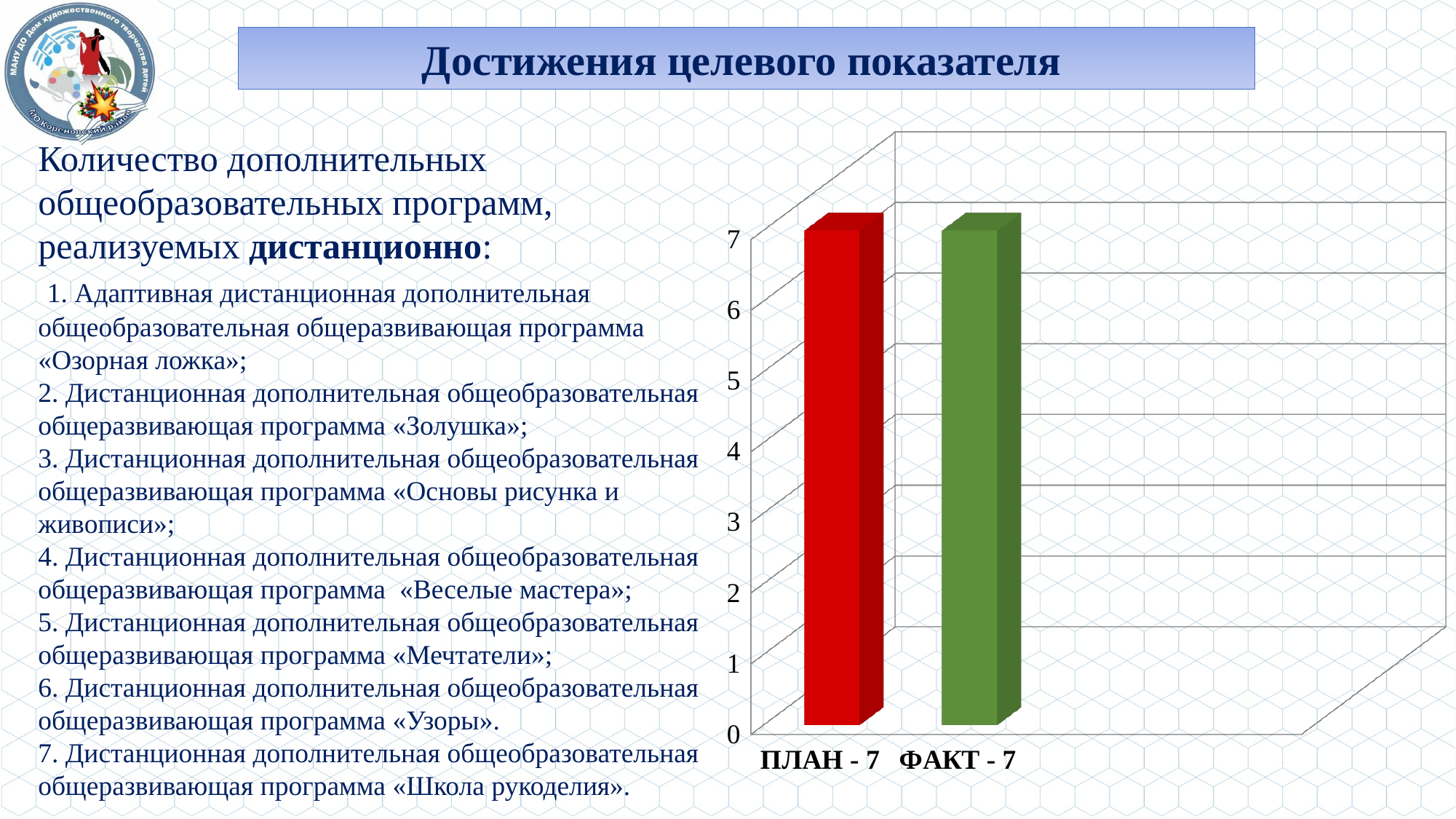
What colour is the ПЛАН bar? red What is the highest tick value shown on the vertical axis of the chart? 7 What is the value for ПЛАН in the chart? 7 What kind of chart is shown on the slide? bar chart Do the values rise, fall or stay the same from ПЛАН to ФАКТ? stay the same What are the two category labels on the horizontal axis of the chart? ПЛАН - 7 and ФАКТ - 7 Is the value for ПЛАН greater or less than 3? greater Is the value for ФАКТ greater or less than 5? greater What is the value for ФАКТ in the chart? 7 What is the difference between the ПЛАН value and the ФАКТ value? 0 How many bars are plotted in the chart? 2 What colour is the ФАКТ bar? green